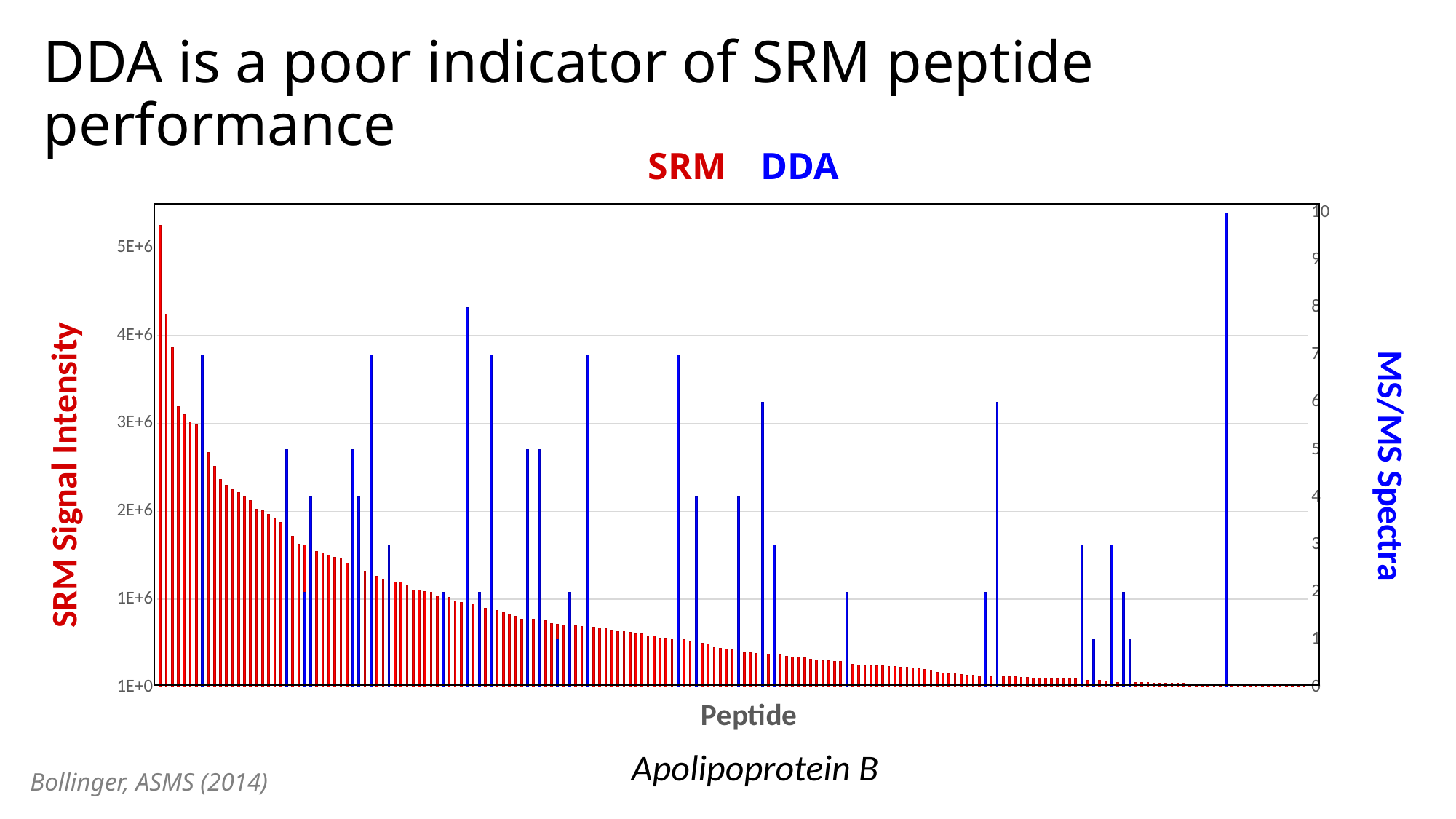
How many series does the legend above the chart list? 2 Which series is drawn in red? SRM What is the label of the right-hand vertical axis? MS/MS Spectra What is the highest tick value shown on the right-hand axis? 10 What kind of chart is shown on the slide? bar chart Which series has the tallest bar relative to its own axis, SRM or DDA, at the far right of the chart? DDA Is the tallest blue DDA bar greater or less than 5 on the right axis? greater Is the tallest red SRM bar greater or less than 4E+6 on the left axis? greater Do the red SRM bars rise or fall from left to right along the x axis? fall Is the tallest blue DDA bar greater or less than 8 on the right axis? greater